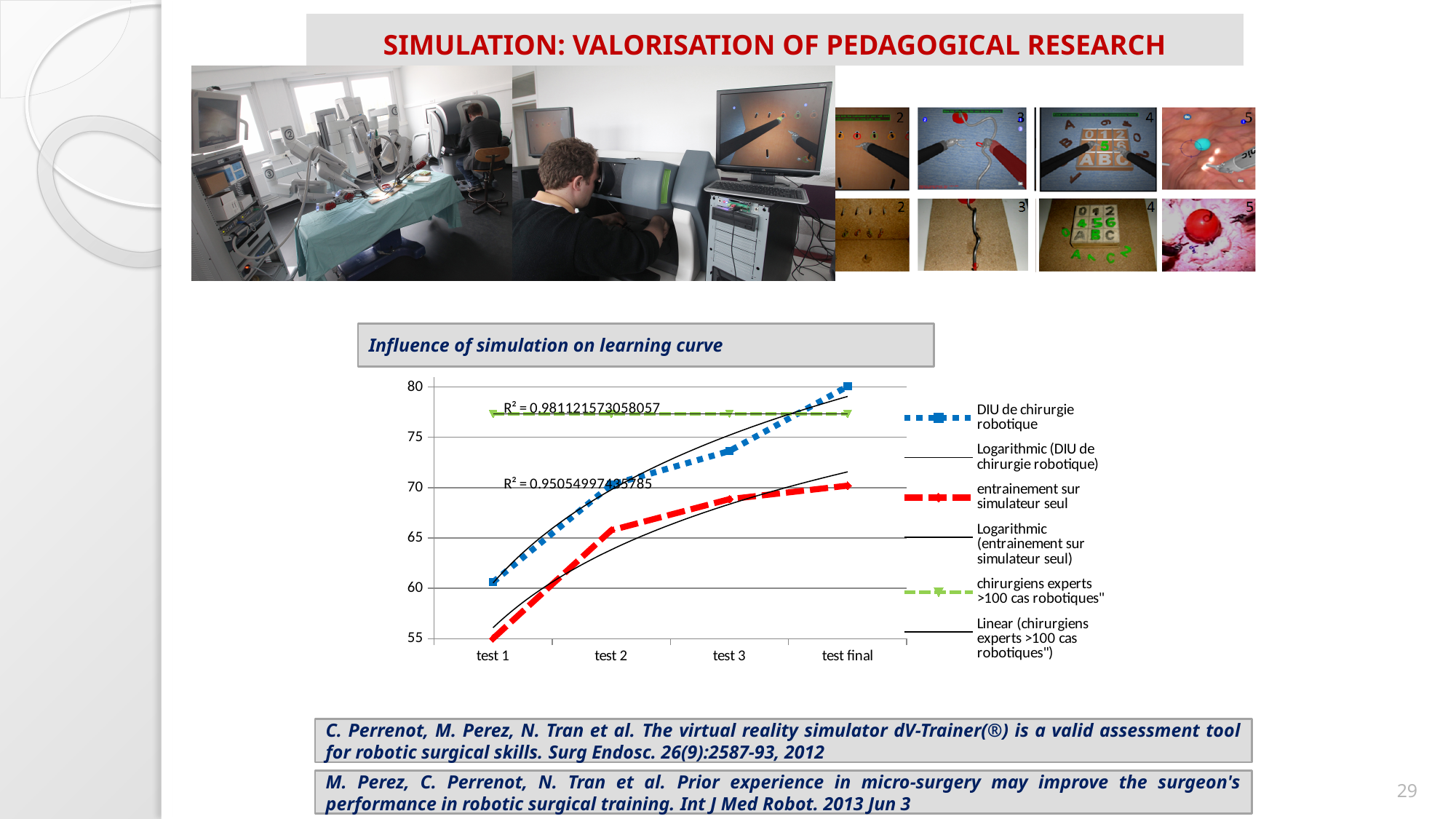
What is the title shown above the learning curve chart? Influence of simulation on learning curve How many categories are shown on the x axis of the learning curve chart? 4 Is the value for 'entrainement sur simulateur seul' at test final greater or less than 65? greater At test 1, which series has the lower value: 'DIU de chirurgie robotique' or 'entrainement sur simulateur seul'? entrainement sur simulateur seul Does the 'DIU de chirurgie robotique' series rise or fall from test 1 to test final? rise Is the value for 'DIU de chirurgie robotique' at test final greater or less than 75? greater How many entries does the legend of the learning curve chart list? 6 What kind of chart is shown under the heading 'Influence of simulation on learning curve'? line chart What R² value is printed near the top of the learning curve chart, next to the green dashed line? R² = 0.981121573058057 Is the value for 'DIU de chirurgie robotique' at test 1 greater or less than 65? less At test 3, which series has the higher value: 'DIU de chirurgie robotique' or 'entrainement sur simulateur seul'? DIU de chirurgie robotique